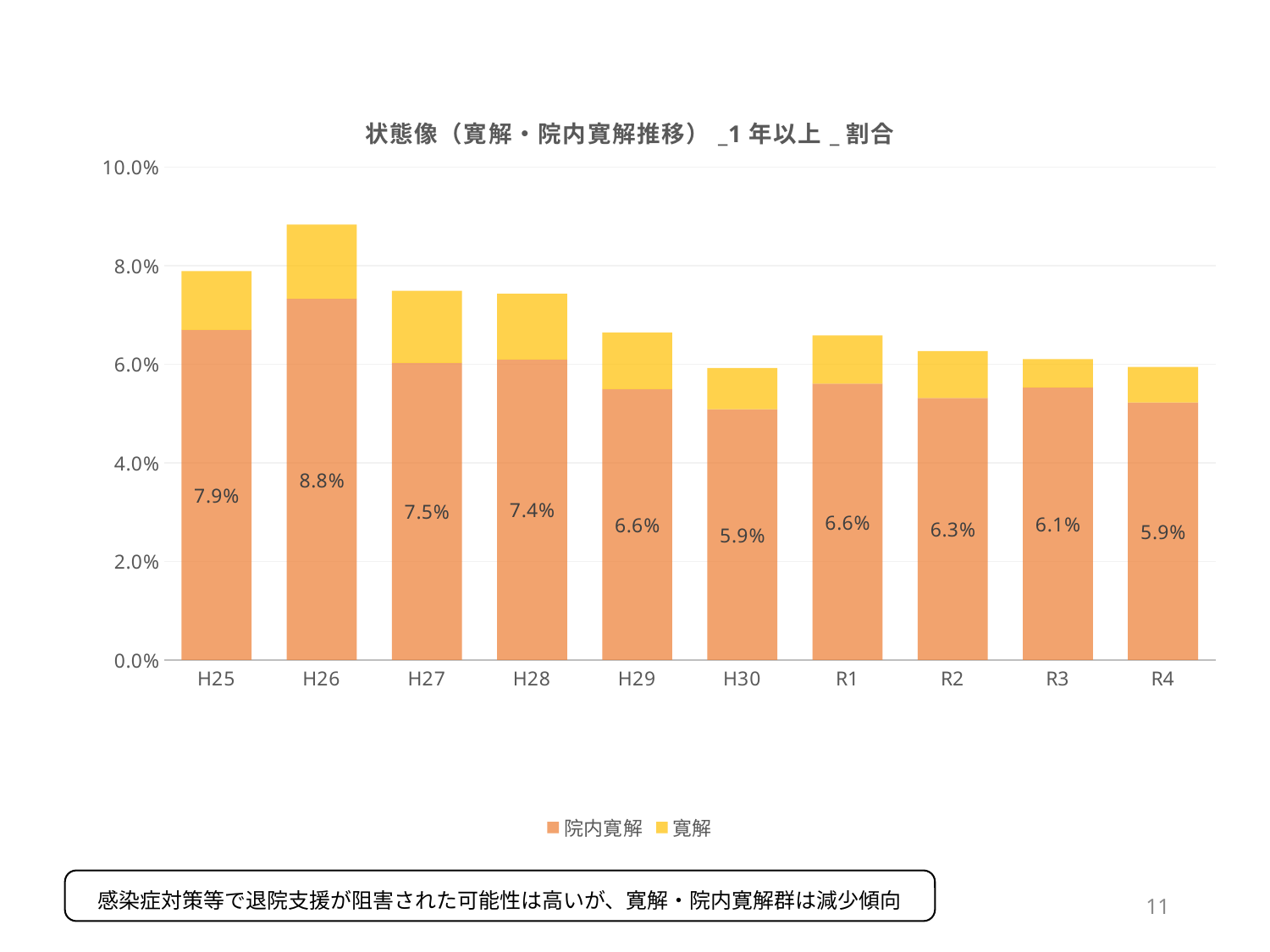
Which year has the highest total bar? H26 Is the 院内寛解 value for H26 greater or less than 6.0%? greater What is the difference between the labelled totals for H26 and H25? 0.9% Do the labelled totals generally rise or fall from H26 to R4? Fall How many series does the legend list? 2 Which labelled total is larger, H27 or H28? H27 What is the total value labelled on the bar for R4? 5.9% How many years are shown on the x axis? 10 What kind of chart is shown on the slide? Stacked bar chart What is the total value labelled on the bar for H26? 8.8% Which series is shown in yellow according to the legend? 寛解 Is the 院内寛解 value for H30 greater or less than 6.0%? less